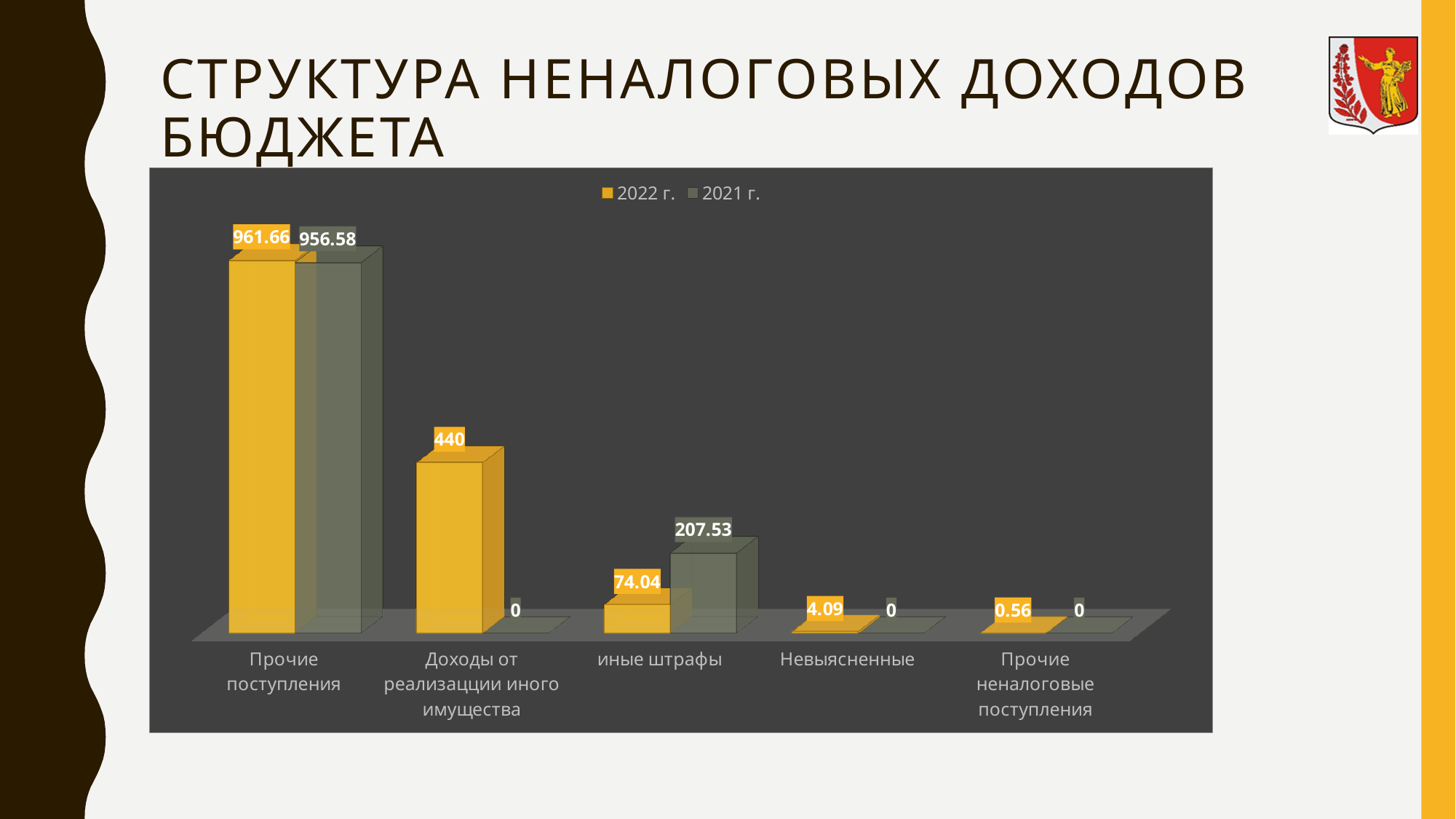
Which category has the lowest value for 2022 г.? Прочие неналоговые поступления For иные штрафы, which series has the larger value, 2022 г. or 2021 г.? 2021 г. How many categories are shown on the x axis? 5 Which category has the highest value for 2022 г.? Прочие поступления What is the difference between the 2021 г. and 2022 г. values for иные штрафы? 133.49 What is the value for 2022 г. for Доходы от реализации иного имущества? 440 What is the difference between the 2022 г. and 2021 г. values for Прочие поступления? 5.08 How many series does the legend list? 2 What is the value for 2022 г. for Прочие поступления? 961.66 What is the value for 2021 г. for иные штрафы? 207.53 What is the value for 2021 г. for Невыясненные? 0 What kind of chart is shown on the slide? Bar chart